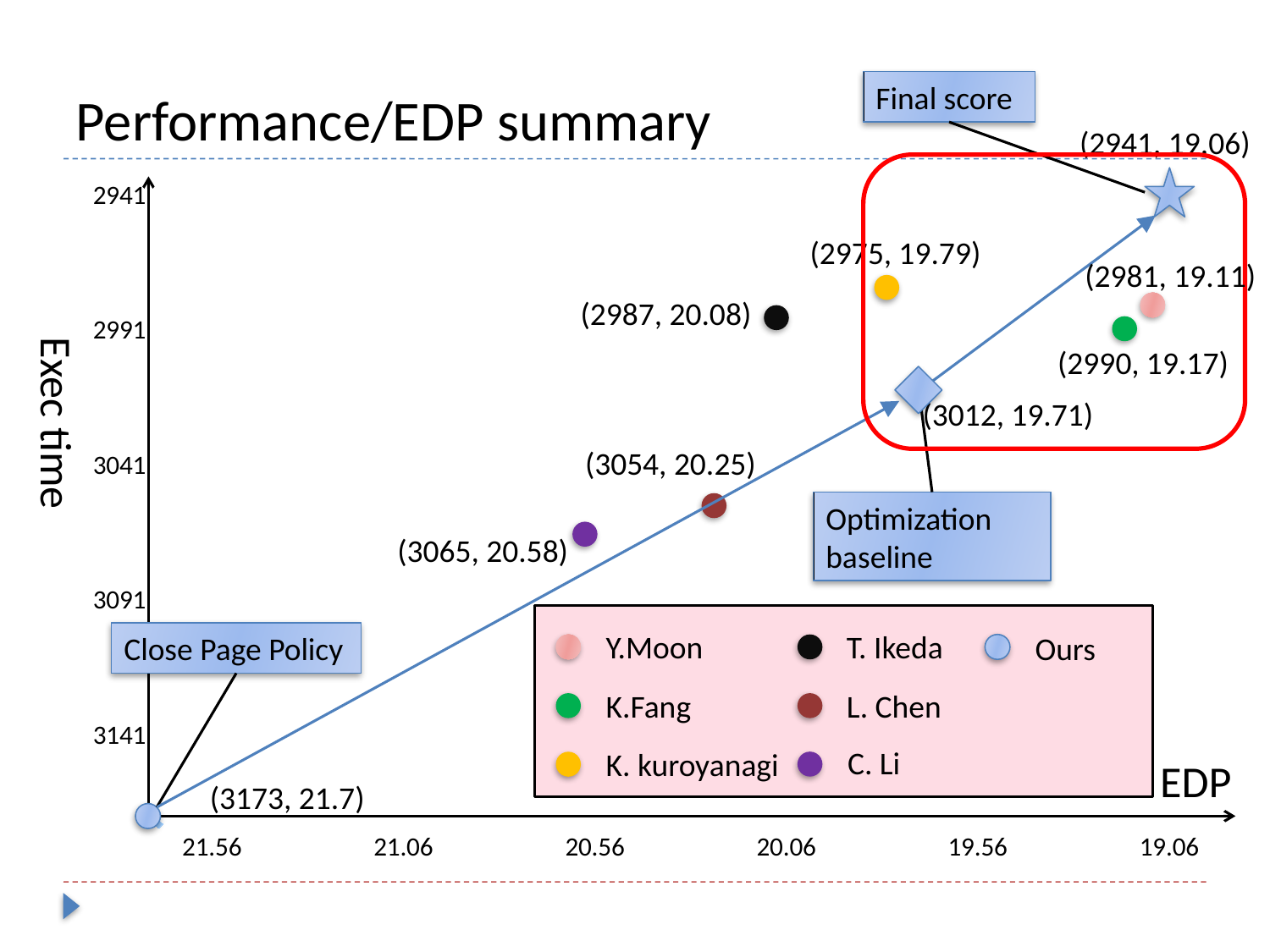
What are the coordinates labelled for the K. kuroyanagi point? (2975, 19.79) What are the coordinates labelled for the Close Page Policy point? (3173, 21.7) What is the difference in exec time between the Close Page Policy point (3173) and the Final score point (2941)? 232 What are the coordinates labelled for the Final score point? (2941, 19.06) What is the label of the horizontal axis? EDP What are the coordinates labelled for the C. Li point? (3065, 20.58) What kind of chart is shown on the slide? scatter chart Which point has the lower EDP, T. Ikeda or L. Chen? T. Ikeda Which labelled point has the highest exec time? Close Page Policy (3173, 21.7) What is the difference in EDP between the Optimization baseline point (19.71) and the Final score point (19.06)? 0.65 How many entries does the legend list? 7 What are the coordinates labelled for the Optimization baseline point? (3012, 19.71)